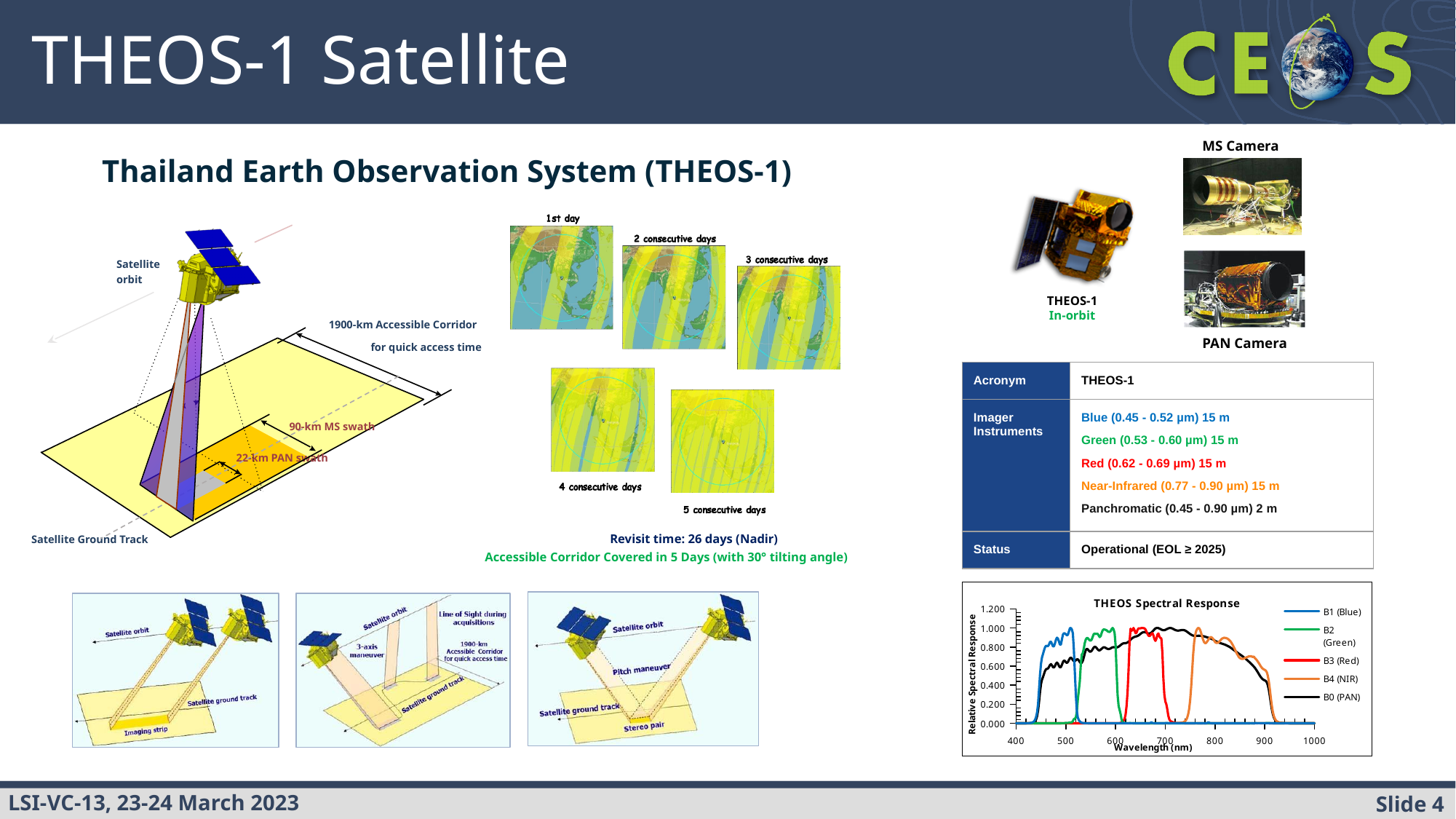
What is the highest tick value shown on the y-axis of the THEOS Spectral Response chart? 1.200 How many series does the legend of the THEOS Spectral Response chart list? 5 What kind of chart is the THEOS Spectral Response chart? line chart What is the x-axis label of the THEOS Spectral Response chart? Wavelength (nm) In the THEOS Spectral Response chart, at 800 nm, which series has the larger value: B4 (NIR) or B1 (Blue)? B4 (NIR) In the THEOS Spectral Response chart, is the value for B1 (Blue) at 600 nm greater or less than 0.200? less In the THEOS Spectral Response chart, is the value for B0 (PAN) at 700 nm greater or less than 0.800? greater In the THEOS Spectral Response chart, is the value for B4 (NIR) at 500 nm greater or less than 0.200? less What is the title of the chart at the bottom right of the slide? THEOS Spectral Response In the THEOS Spectral Response chart, which series covers the widest range of wavelengths? B0 (PAN)